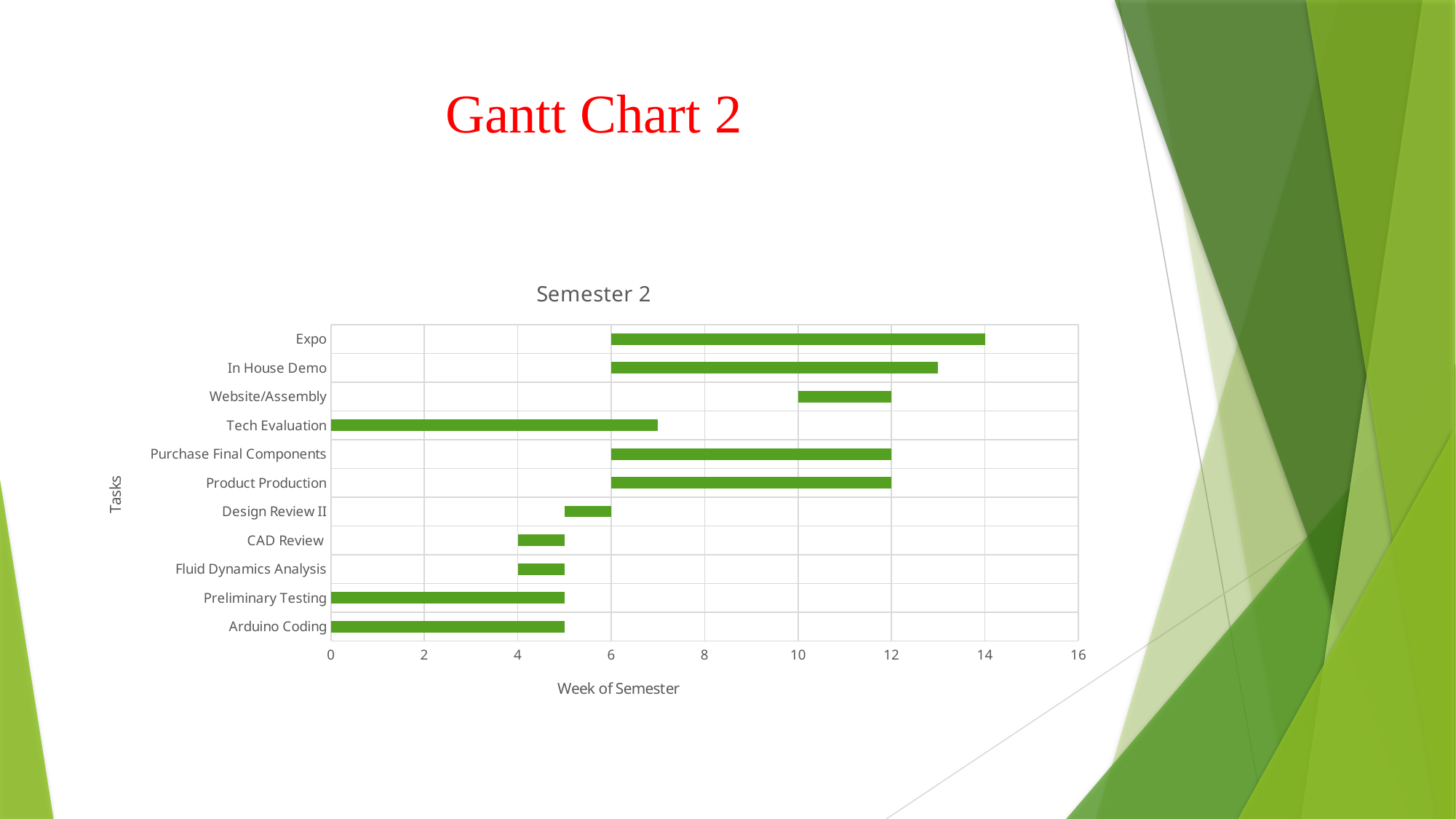
How many tasks are listed on the chart? 11 Which bar ends later, Expo or In House Demo? Expo Is the end of the In House Demo bar greater or less than 12? greater Is the end of the Tech Evaluation bar greater or less than 8? less What kind of chart is shown on the slide? bar chart In which week does the Expo bar end? 14 In which week does the Website/Assembly bar start? 10 What is the title of the chart? Semester 2 In which week does the Product Production bar end? 12 Which task's bar extends furthest along the Week of Semester axis? Expo In which week does the Purchase Final Components bar start? 6 What is the label of the horizontal axis? Week of Semester